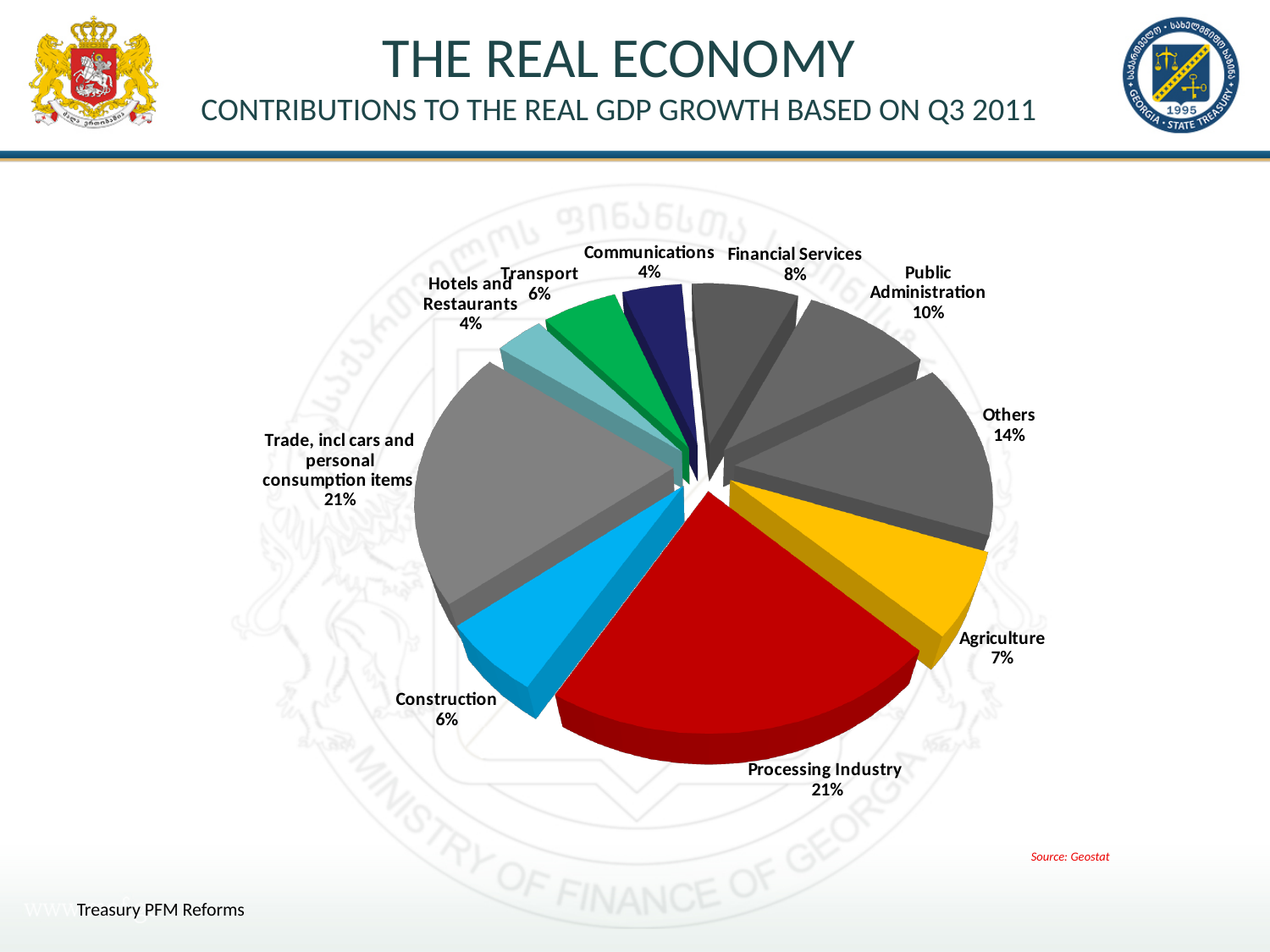
What is the difference between the shares for Processing Industry and Agriculture? 14% What is the value shown for Financial Services? 8% What is the value shown for Construction? 6% What is the value shown for Others? 14% What is the value shown for Agriculture? 7% What is the difference between the shares for Others and Financial Services? 6% What is the value shown for Public Administration? 10% Which is larger, the share for Others or the share for Public Administration? Others How many slices does the pie chart have? 10 What is the subtitle of the chart on the slide? Contributions to the real GDP growth based on Q3 2011 What share of real GDP growth is contributed by Processing Industry? 21% What kind of chart is shown on the slide? pie chart